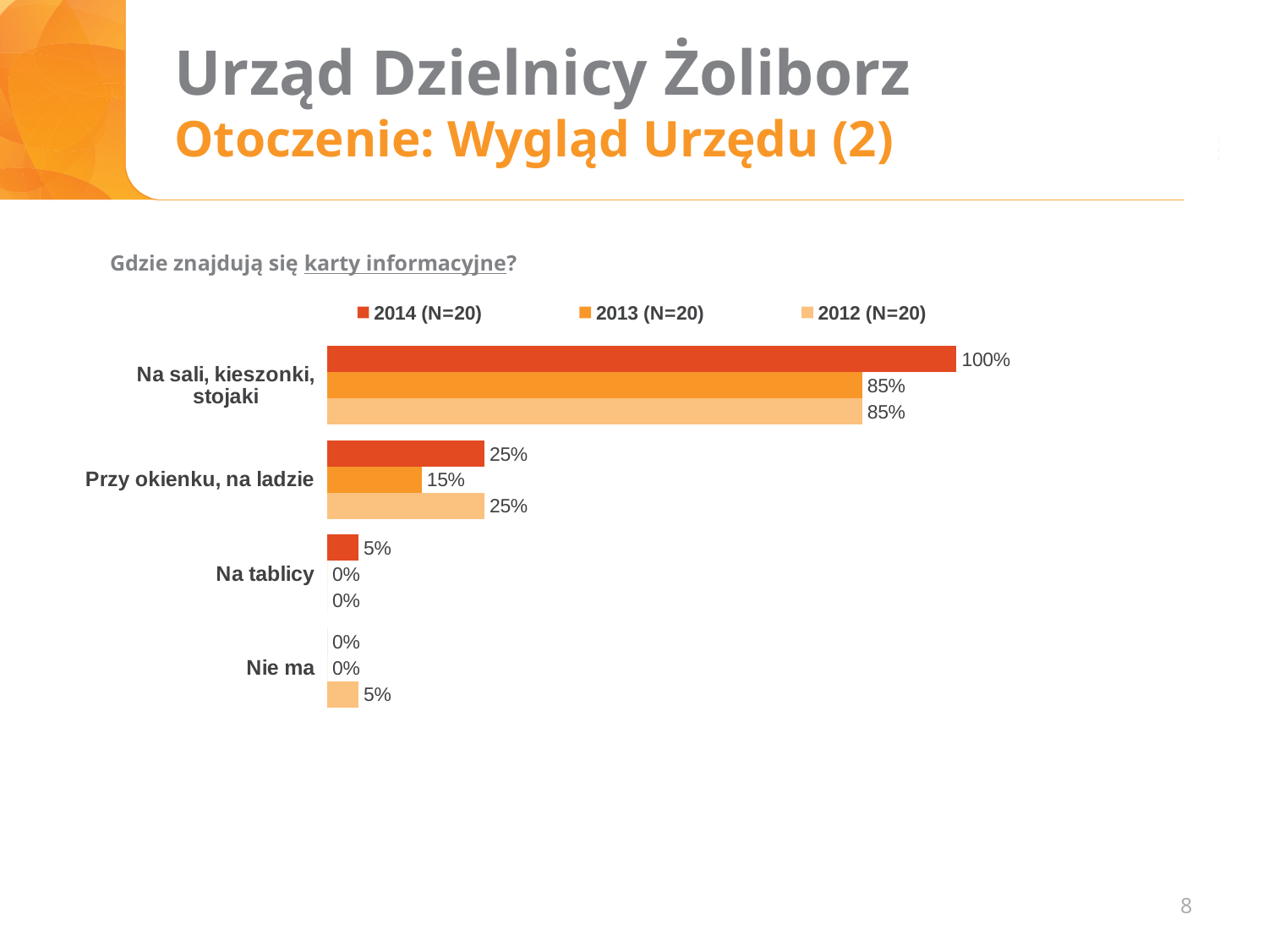
What is the value for "Na sali, kieszonki, stojaki" in the 2014 (N=20) series? 100% What kind of chart is shown on the slide? Bar chart Which category has the highest value in the 2014 (N=20) series? Na sali, kieszonki, stojaki How many categories are shown on the chart? 4 What is the value for "Nie ma" in the 2012 (N=20) series? 5% How many series does the legend list? 3 What is the difference between the 2014 (N=20) and 2013 (N=20) values for "Na sali, kieszonki, stojaki"? 15% What question does the chart answer, as written above it? Gdzie znajdują się karty informacyjne? What is the difference between the 2014 (N=20) and 2013 (N=20) values for "Przy okienku, na ladzie"? 10% Which is larger for "Przy okienku, na ladzie": the 2014 (N=20) value or the 2013 (N=20) value? 2014 (N=20) What is the value for "Przy okienku, na ladzie" in the 2013 (N=20) series? 15% What is the value for "Na tablicy" in the 2014 (N=20) series? 5%